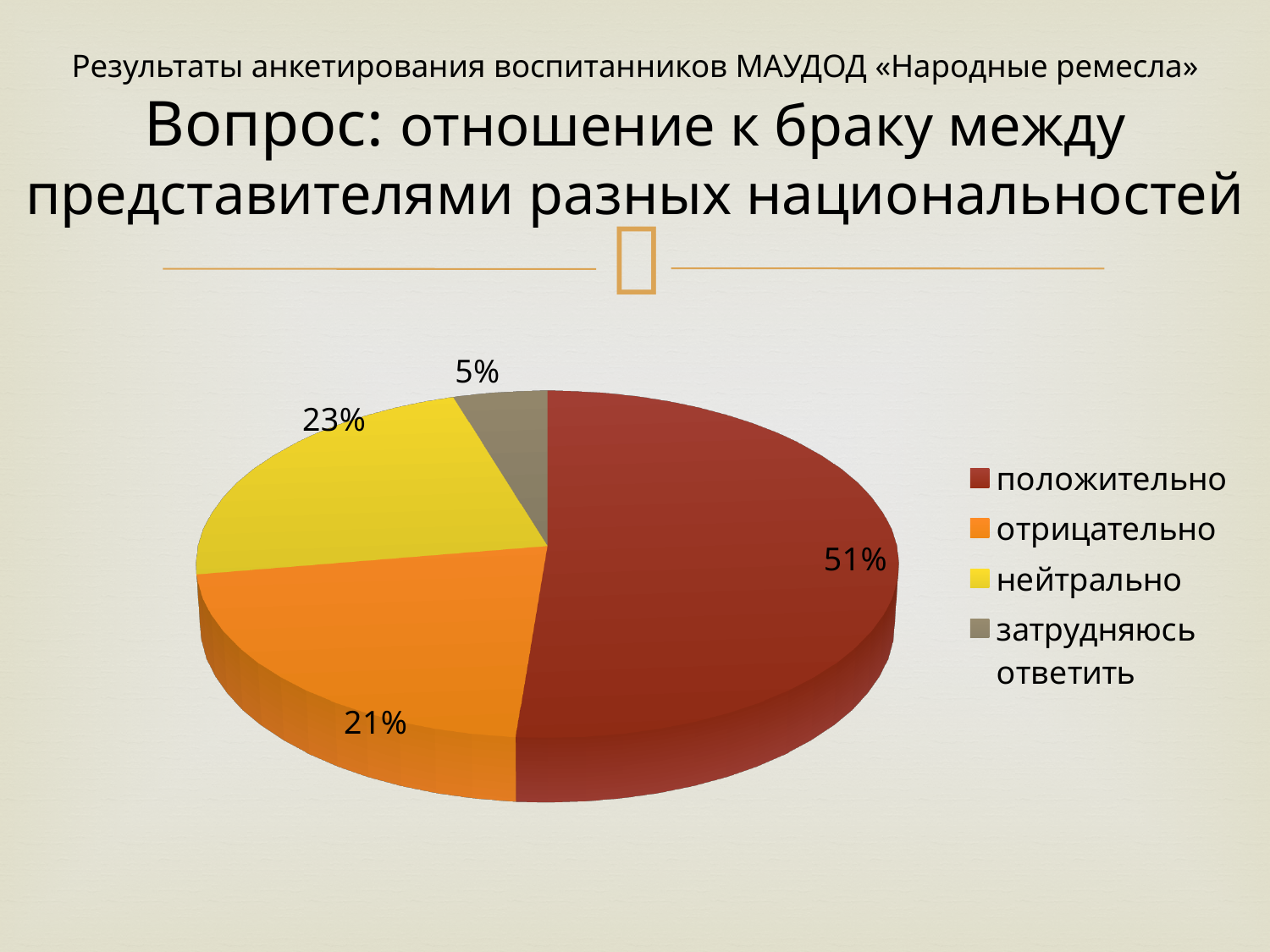
What percentage of respondents answered "отрицательно"? 21% What percentage of respondents answered "затрудняюсь ответить"? 5% Which is larger, the share for "нейтрально" or the share for "отрицательно"? нейтрально What percentage of respondents answered "нейтрально"? 23% What colour is the slice for "нейтрально"? yellow What percentage of respondents answered "положительно"? 51% How many categories does the legend list? 4 Which answer has the largest share of the pie? положительно What is the combined share of "отрицательно" and "затрудняюсь ответить"? 26% Which answer has the smallest share of the pie? затрудняюсь ответить What is the difference in percentage points between "положительно" and "нейтрально"? 28 What kind of chart is shown on the slide? pie chart